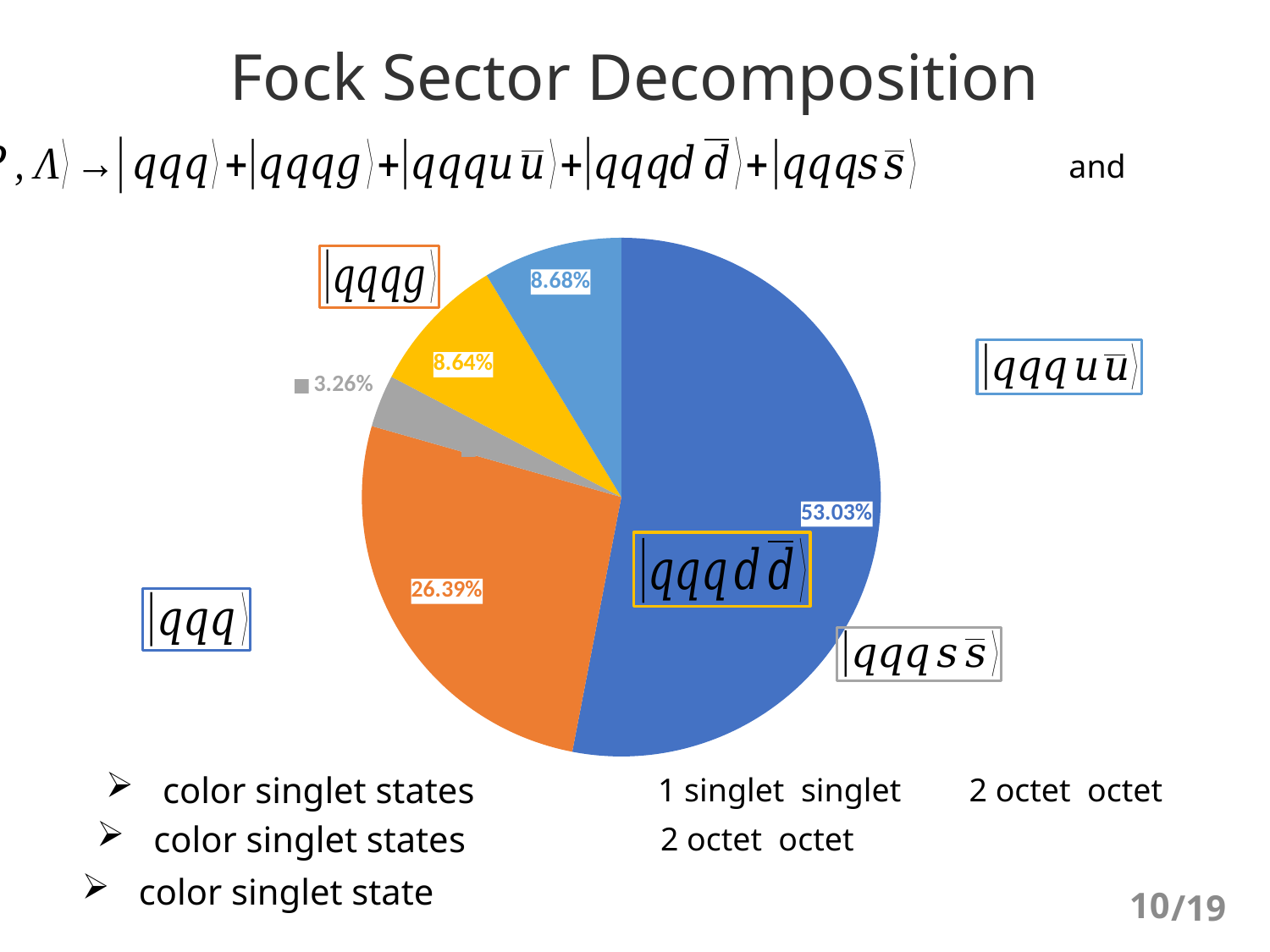
What is the combined share of the yellow (8.64%) and light blue (8.68%) slices? 17.32% What is the percentage shown on the largest slice of the pie chart? 53.03% What is the percentage shown on the smallest slice of the pie chart? 3.26% What is the title of the slide containing the pie chart? Fock Sector Decomposition What kind of chart is shown on the slide? pie chart Which slice is larger, the dark blue slice or the orange slice? the dark blue slice What percentage is shown on the gray slice of the pie chart? 3.26% What percentage is shown on the orange slice of the pie chart? 26.39% What is the difference between the dark blue slice (53.03%) and the orange slice (26.39%)? 26.64% What percentage is shown on the yellow slice of the pie chart? 8.64% How many slices does the pie chart have? 5 What percentage is shown on the light blue slice of the pie chart? 8.68%